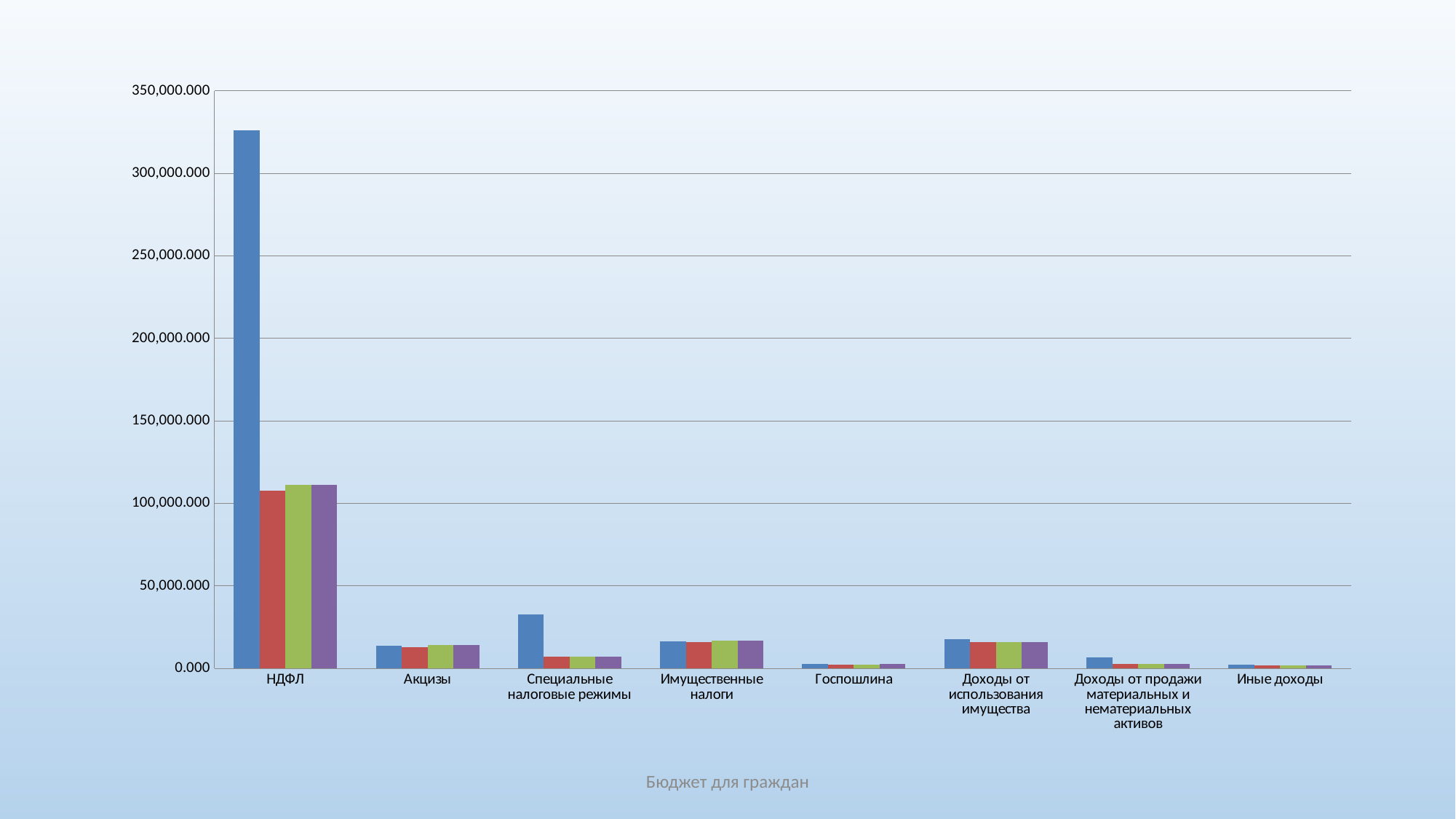
Is the value of the blue bar for Специальные налоговые режимы greater or less than 50,000.000? less Which is larger: the blue bar for НДФЛ or the blue bar for Акцизы? НДФЛ Which is larger: the blue bar for Доходы от использования имущества or the blue bar for Госпошлина? Доходы от использования имущества Which category has the tallest bar in the chart? НДФЛ What is the highest value shown on the vertical axis of the chart? 350,000.000 Which is larger: the blue bar for Специальные налоговые режимы or the blue bar for Имущественные налоги? Специальные налоговые режимы Is the value of the blue bar for НДФЛ greater or less than 300,000.000? greater Is the value of the red bar for НДФЛ greater or less than 100,000.000? greater What kind of chart is shown on the slide? bar chart How many categories are shown on the x axis of the chart? 8 What text appears below the chart on the slide? Бюджет для граждан